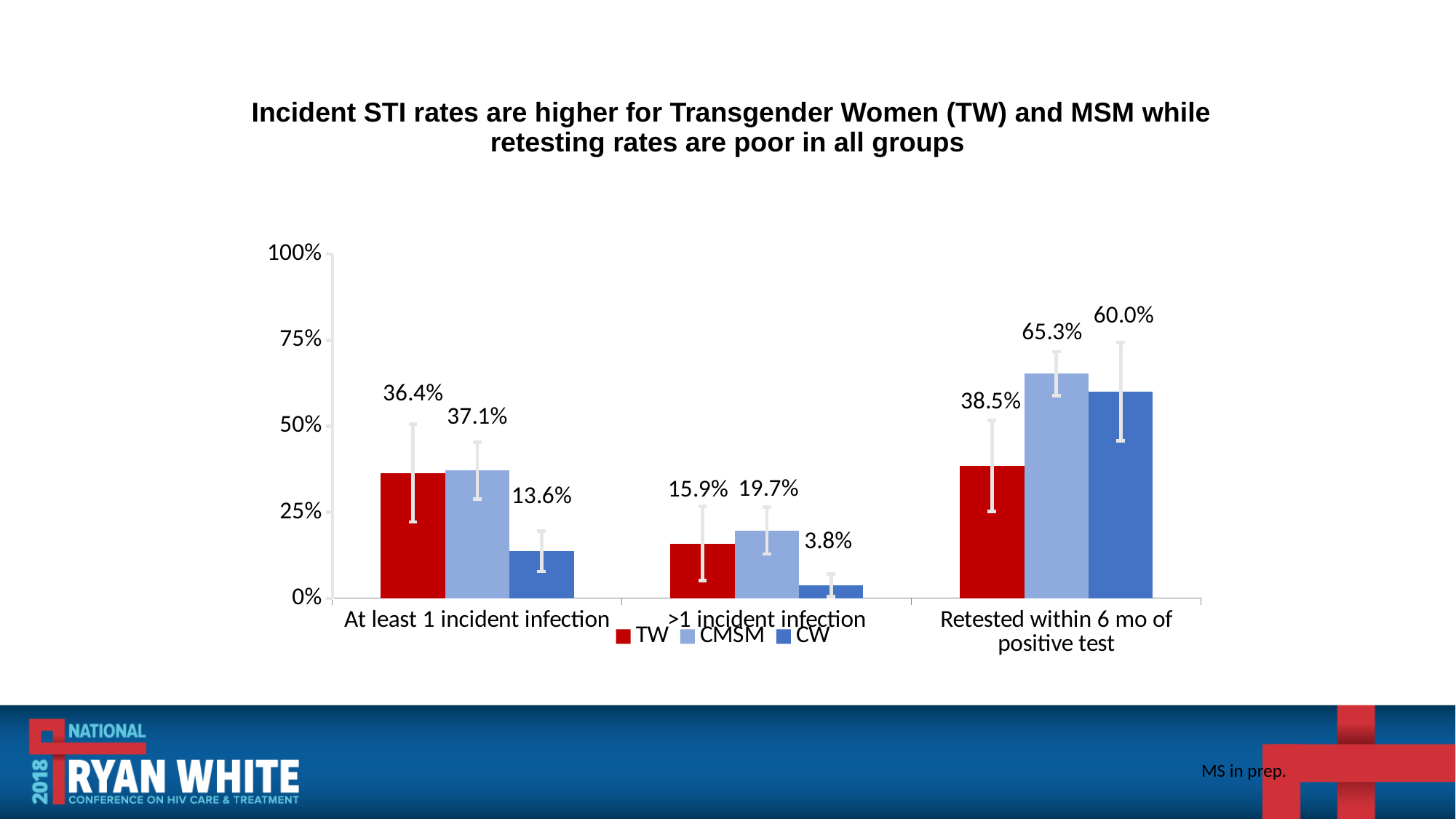
What kind of chart is shown on the slide? Bar chart What is the value for TW in the 'At least 1 incident infection' category? 36.4% What is the value for CMSM in the 'Retested within 6 mo of positive test' category? 65.3% Which series has the highest value in the 'Retested within 6 mo of positive test' category? CMSM How many series does the legend list? 3 What colour are the TW bars? Red What is the value for CW in the '>1 incident infection' category? 3.8% Which is larger in the '>1 incident infection' category: TW or CMSM? CMSM Is the value for CW in the 'Retested within 6 mo of positive test' category greater or less than 50%? greater What is the difference between the CMSM and TW values in the 'Retested within 6 mo of positive test' category? 26.8% How many categories are shown on the x axis? 3 Which series has the lowest value in the 'At least 1 incident infection' category? CW